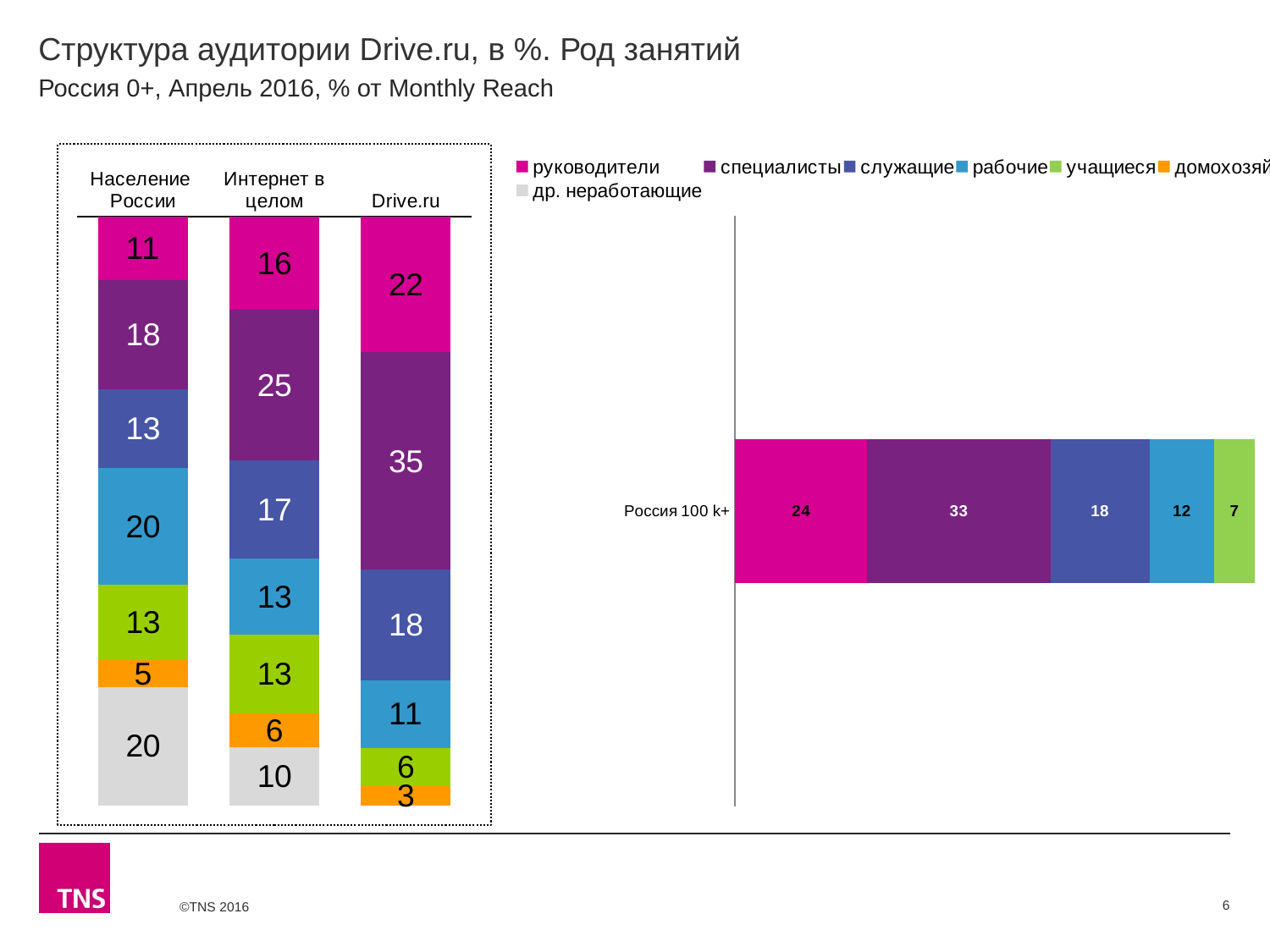
What type of chart is the right chart? Stacked bar chart On the right chart, what is the difference between the руководители and служащие values for Россия 100 k+? 6 On the left chart, which segment is the smallest in the Drive.ru bar? домохозяйки How many bars does the left chart show? 3 On the left chart, which segment is the largest in the Drive.ru bar? специалисты On the left chart, which bar has the larger руководители value, Интернет в целом or Drive.ru? Drive.ru On the left chart, what is the value for рабочие in the Интернет в целом bar? 13 On the left chart, what is the difference between the специалисты values for Drive.ru and Население России? 17 On the left chart, what is the value for руководители in the Население России bar? 11 On the right chart, what is the value for специалисты in the Россия 100 k+ bar? 33 On the left chart, what is the value for специалисты in the Drive.ru bar? 35 On the right chart, what is the value for учащиеся in the Россия 100 k+ bar? 7